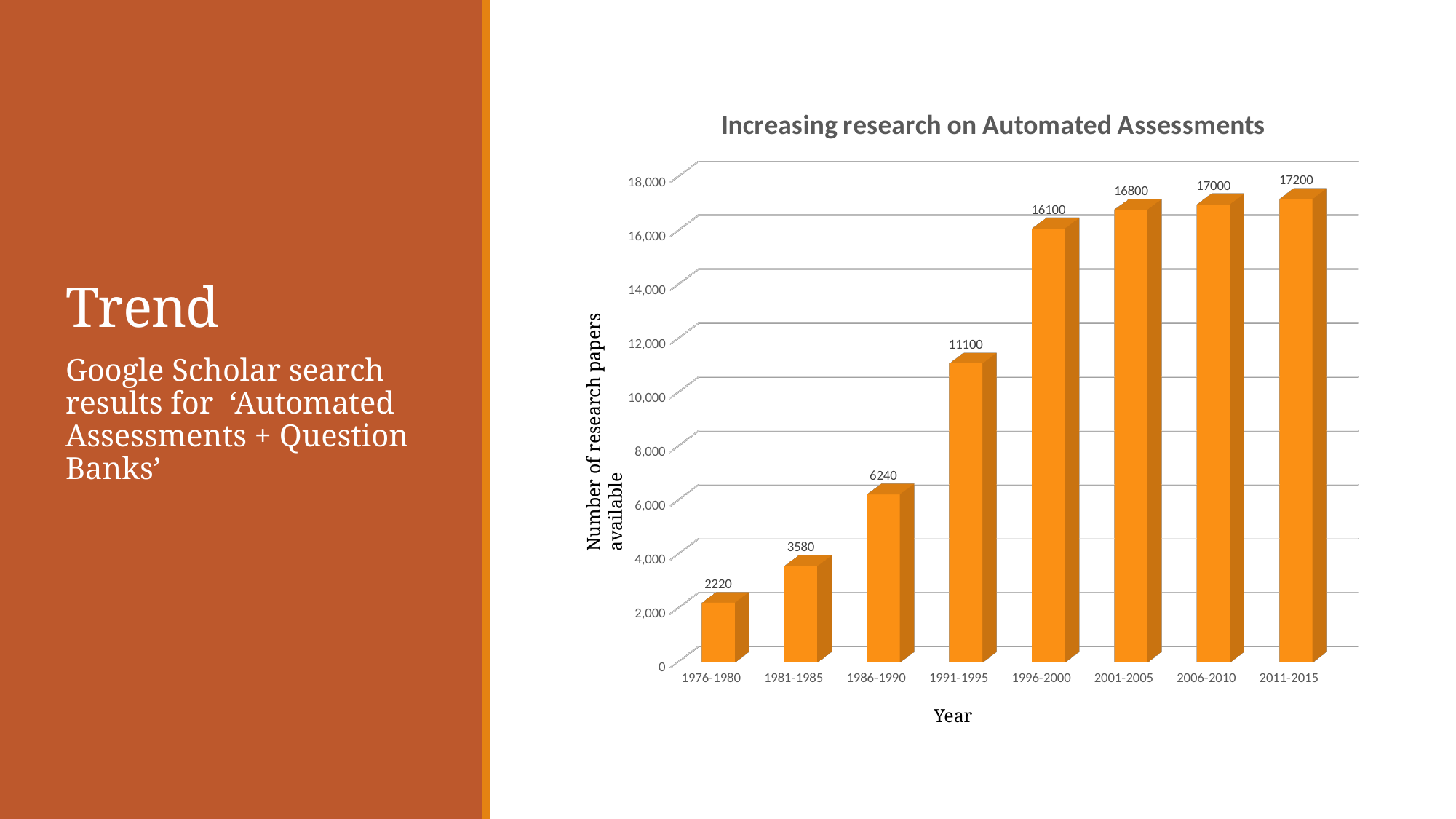
Which year range has the lowest number of research papers available? 1976-1980 What is the number of research papers available for 2006-2010? 17000 What is the difference in research papers between 2011-2015 and 2001-2005? 400 Do the values rise or fall from 1976-1980 to 2011-2015? Rise Which has more research papers available, 1981-1985 or 1986-1990? 1986-1990 What is the number of research papers available for 1976-1980? 2220 What kind of chart is shown on the slide? Bar chart What is the number of research papers available for 1996-2000? 16100 What is the difference in research papers between 1991-1995 and 1986-1990? 4860 Which year range has the highest number of research papers available? 2011-2015 How many year ranges are shown on the x axis? 8 Is the value for 1991-1995 greater or less than 10,000? greater